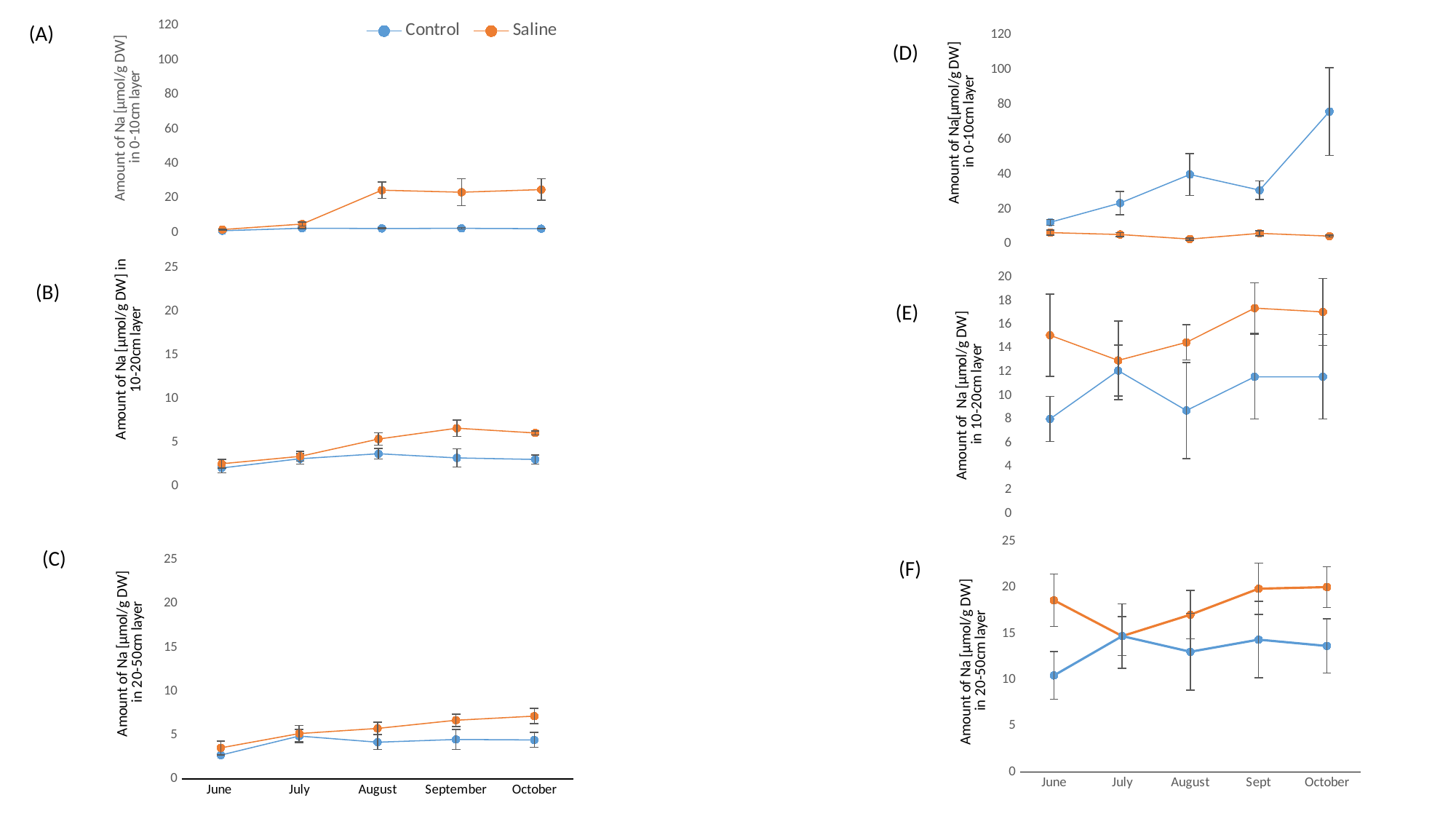
How many series does the legend at the top of the slide list? 2 In chart (B), does the Saline series generally rise or fall from June to September? rise In chart (A), is the Saline value for August greater or less than 20? greater What kind of chart is chart (A)? line chart In chart (E), is the Control value for August greater or less than 10? less How many months are plotted along the x axis of chart (C)? 5 In chart (A), is the Control value for October greater or less than 20? less In chart (F), which series has the larger value in June, Control or Saline? Saline What are the two series named in the legend? Control and Saline